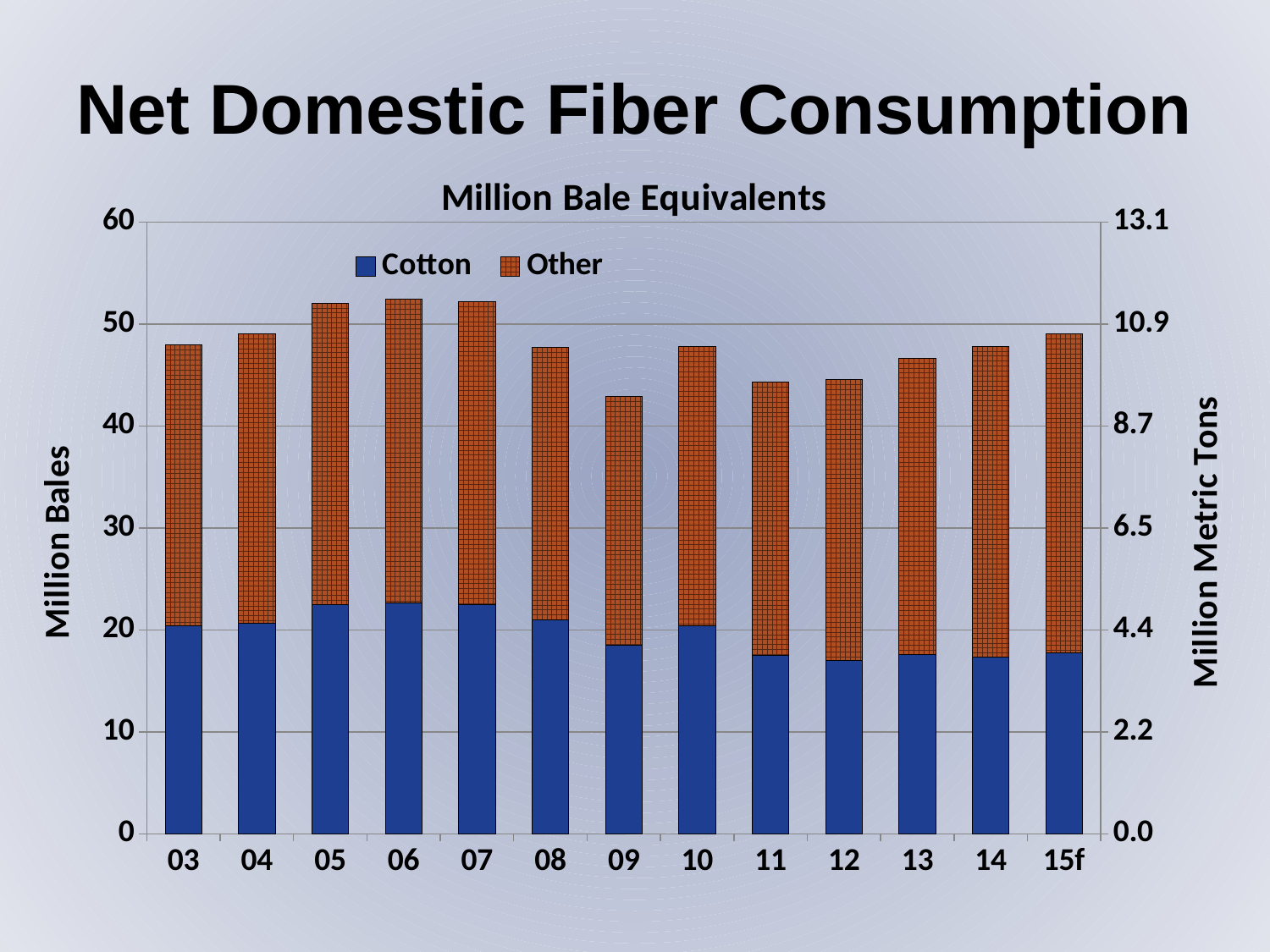
Is the Cotton value for 09 greater or less than 20 million bales? less Is the total bar for 09 greater or less than 50 million bales? less Which year has the larger total bar, 06 or 09? 06 What is the label on the right-hand vertical axis? Million Metric Tons What kind of chart is shown on the slide? Stacked bar chart Is the Cotton value for 05 greater or less than 20 million bales? greater How many series does the legend list? 2 Do the total bars rise or fall from 06 to 09? fall How many years (categories) are shown on the x axis? 13 Which year has the larger Cotton value, 05 or 12? 05 Which year has the lowest total fiber consumption? 09